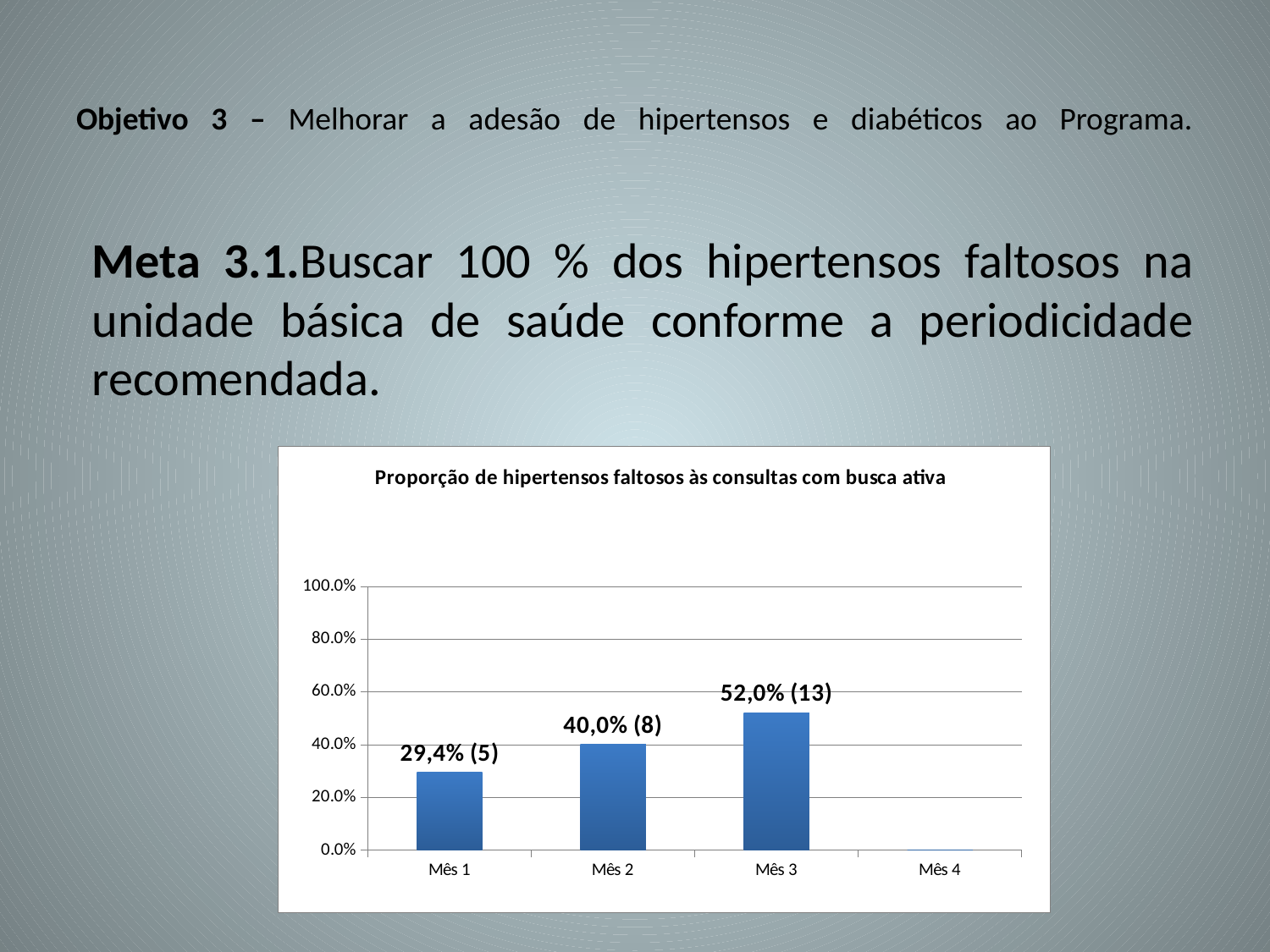
What kind of chart is shown on the slide? Bar chart What value is shown for Mês 3 in the chart? 52,0% (13) What value is shown for Mês 1 in the chart? 29,4% (5) How many more hypertensive patients are counted in Mês 3 than in Mês 1, according to the numbers in parentheses? 8 What value is shown for Mês 2 in the chart? 40,0% (8) Do the values rise or fall from Mês 1 to Mês 3? Rise How many month categories are shown on the x axis of the chart? 4 Among Mês 1, Mês 2 and Mês 3, which month has the lowest proportion? Mês 1 Which is larger, the value for Mês 1 or the value for Mês 2? Mês 2 Which month has the highest proportion in the chart? Mês 3 What is the difference in percentage points between the values for Mês 3 and Mês 2? 12,0 percentage points Is the value for Mês 3 greater or less than 40.0%? greater